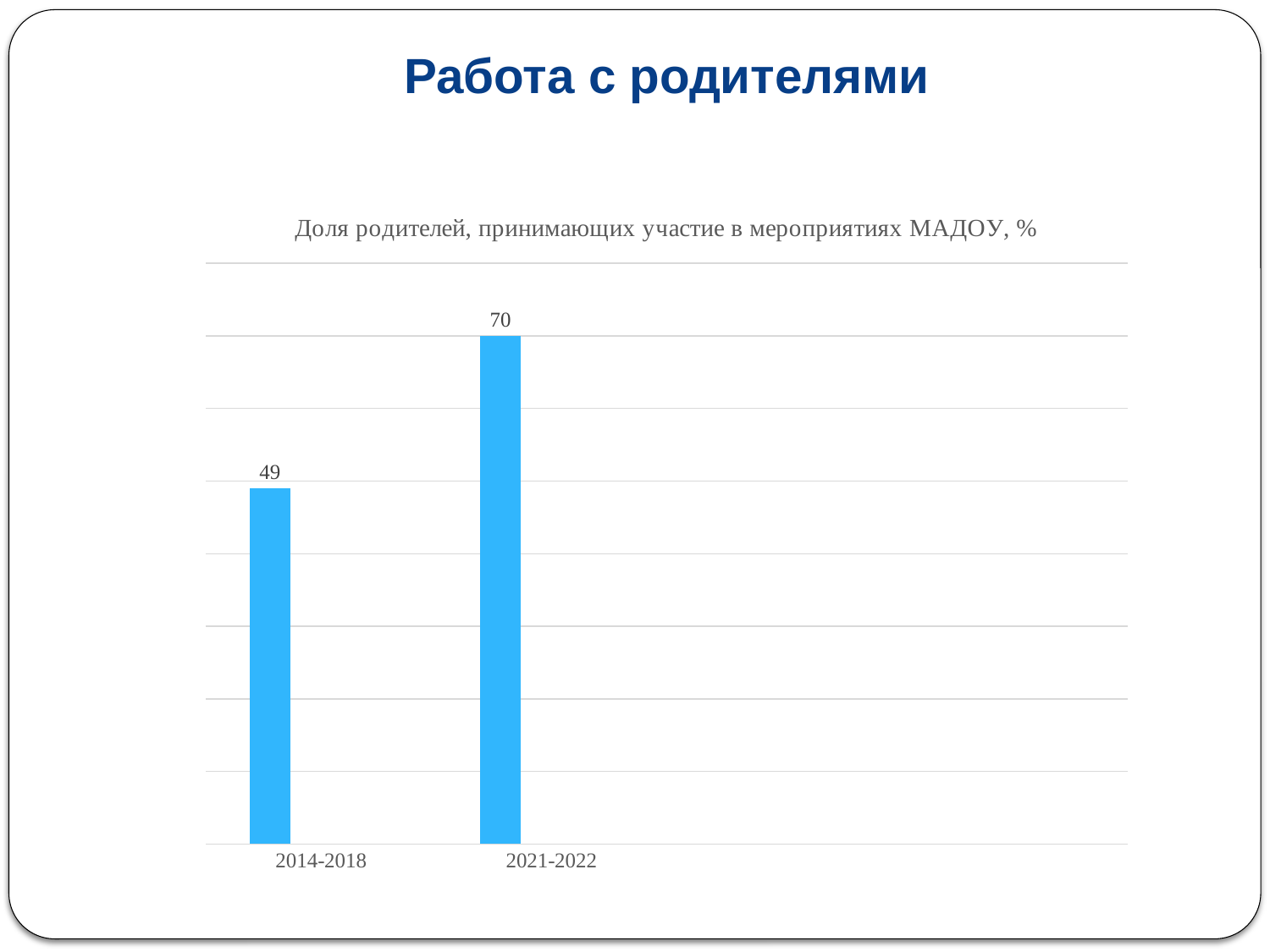
Which period has the lowest value? 2014-2018 What is the value for 2021-2022? 70 How many categories are shown on the x axis? 2 Which period has the highest value? 2021-2022 Which is larger, the value for 2014-2018 or the value for 2021-2022? 2021-2022 What kind of chart is shown on the slide? bar chart Do the values rise or fall from 2014-2018 to 2021-2022? rise What colour are the bars in the chart? blue What is the title of the chart? Доля родителей, принимающих участие в мероприятиях МАДОУ, % What is the difference between the values for 2021-2022 and 2014-2018? 21 What is the value for 2014-2018? 49